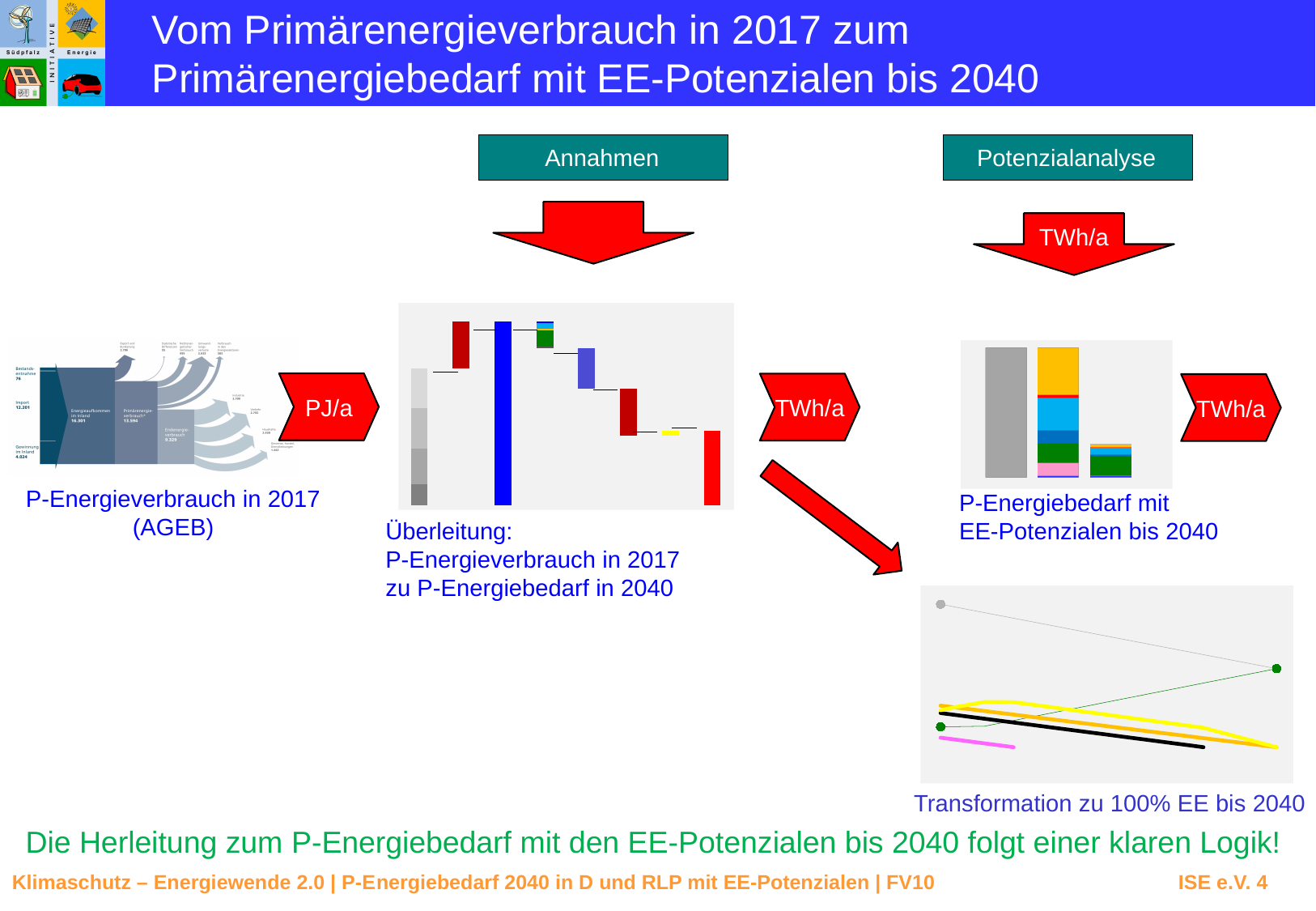
How many charts are shown on the slide? 4 In the chart captioned "Transformation zu 100% EE bis 2040", does the thin green line rise or fall from left to right? rises What kind of chart is the one captioned "P-Energiebedarf mit EE-Potenzialen bis 2040"? bar chart In the chart captioned "P-Energiebedarf mit EE-Potenzialen bis 2040", is the leftmost gray bar taller or shorter than the rightmost bar? taller In the chart captioned "P-Energiebedarf mit EE-Potenzialen bis 2040", how many bars are shown? 3 What kind of chart is the one captioned "Überleitung: P-Energieverbrauch in 2017 zu P-Energiebedarf in 2040"? bar chart What unit is written on the arrow leading from the Überleitung chart to the chart captioned "P-Energiebedarf mit EE-Potenzialen bis 2040"? TWh/a In the chart captioned "Transformation zu 100% EE bis 2040", does the gray line rise or fall from left to right? falls What unit is written on the arrow between the chart captioned "P-Energieverbrauch in 2017 (AGEB)" and the Überleitung chart? PJ/a What kind of chart is the one captioned "Transformation zu 100% EE bis 2040"? line chart In the chart captioned "Überleitung: P-Energieverbrauch in 2017 zu P-Energiebedarf in 2040", which bar is the tallest? the blue bar